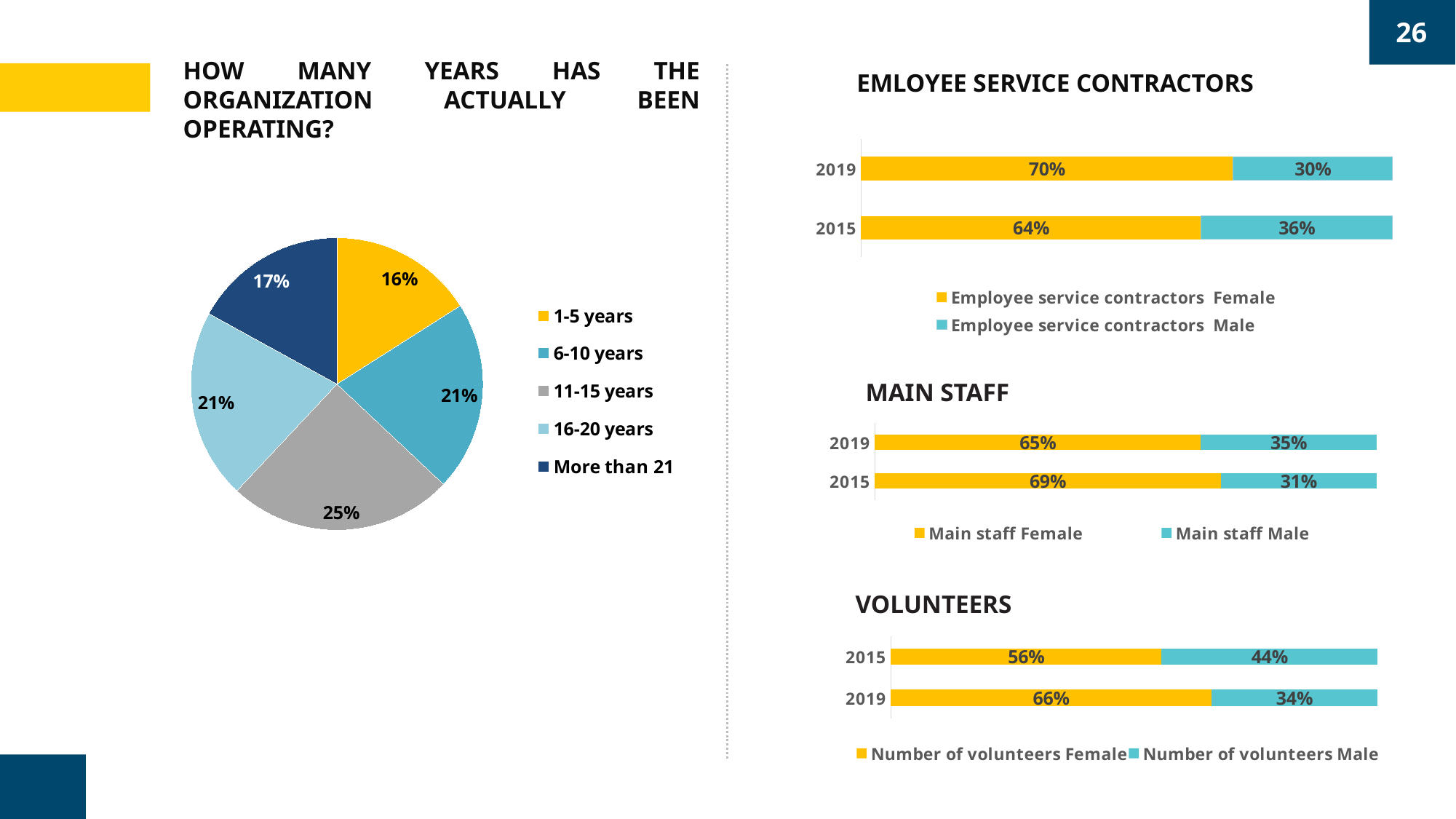
In the VOLUNTEERS chart, what is the Female value for 2015? 56% What kind of chart is the VOLUNTEERS chart? Stacked bar chart In the pie chart on the left, what is the difference between the share for 11-15 years and the share for More than 21? 8% In the EMLOYEE SERVICE CONTRACTORS chart, what is the Male value for 2015? 36% How many series does the legend of the MAIN STAFF chart list? 2 In the EMLOYEE SERVICE CONTRACTORS chart, what is the Female value for 2019? 70% How many categories does the pie chart on the left show? 5 In the pie chart on the left, which category has the largest share? 11-15 years In the pie chart on the left, which category has the smallest share? 1-5 years In the MAIN STAFF chart, which year has the larger Female value, 2015 or 2019? 2015 In the MAIN STAFF chart, what is the difference between the Male values for 2019 and 2015? 4% In the pie chart on the left, what share of organizations have been operating for 11-15 years? 25%